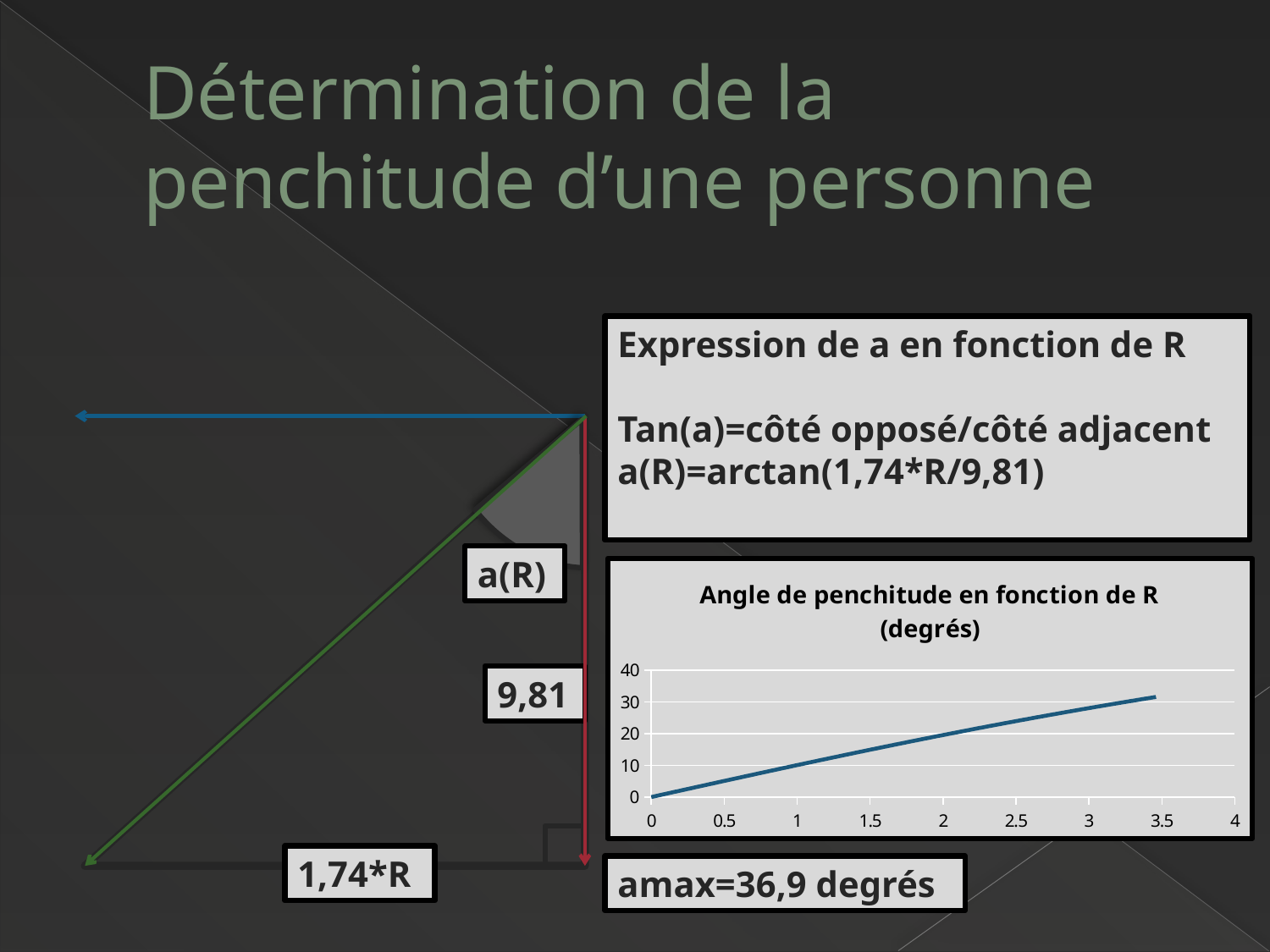
Is the value of the line at R = 3 greater or less than 20? greater What is the maximum value shown on the chart's y axis? 40 What is the title of the chart on the slide? Angle de penchitude en fonction de R (degrés) Is the value of the line at R = 0.5 greater or less than 10? less What kind of chart is shown on the slide? line chart Is the highest value reached by the line greater or less than 40? less At which end of the x axis, R = 0 or R = 3.5, is the angle larger? R = 3.5 Does the plotted angle rise or fall as R increases along the x axis? rise